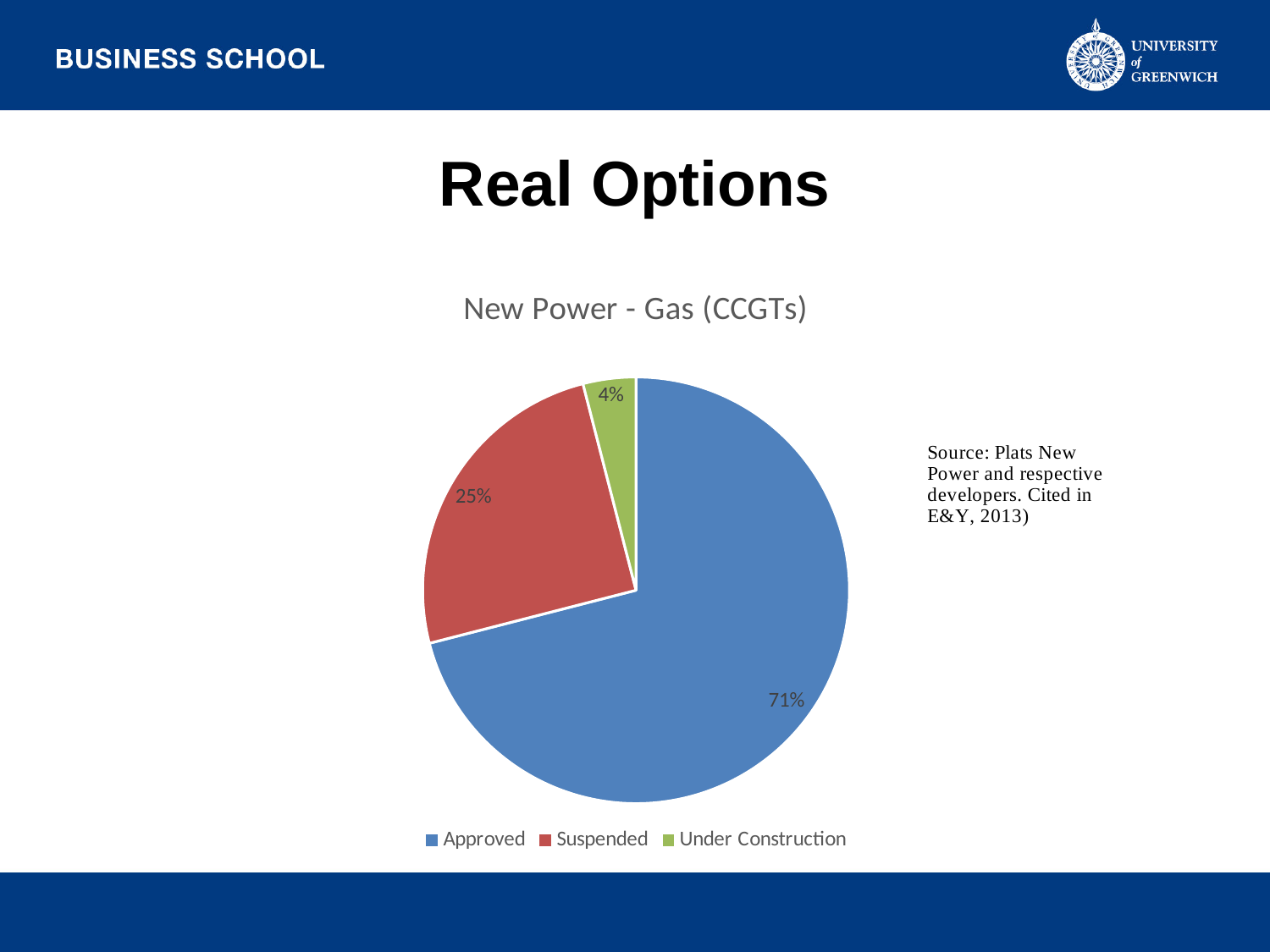
What is the difference in percentage points between the Suspended and Under Construction slices? 21 What share of the pie does Suspended account for? 25% What is the difference in percentage points between the Approved and Suspended slices? 46 Which colour represents the Suspended category in the legend? Red Which category has the smallest slice of the pie? Under Construction Which category has the largest slice of the pie? Approved Which is larger, the Suspended slice or the Under Construction slice? Suspended How many categories are shown in the pie chart? 3 What is the title of the chart? New Power - Gas (CCGTs) What kind of chart is shown on the slide? Pie chart What share of the pie does Approved account for? 71% What share of the pie does Under Construction account for? 4%